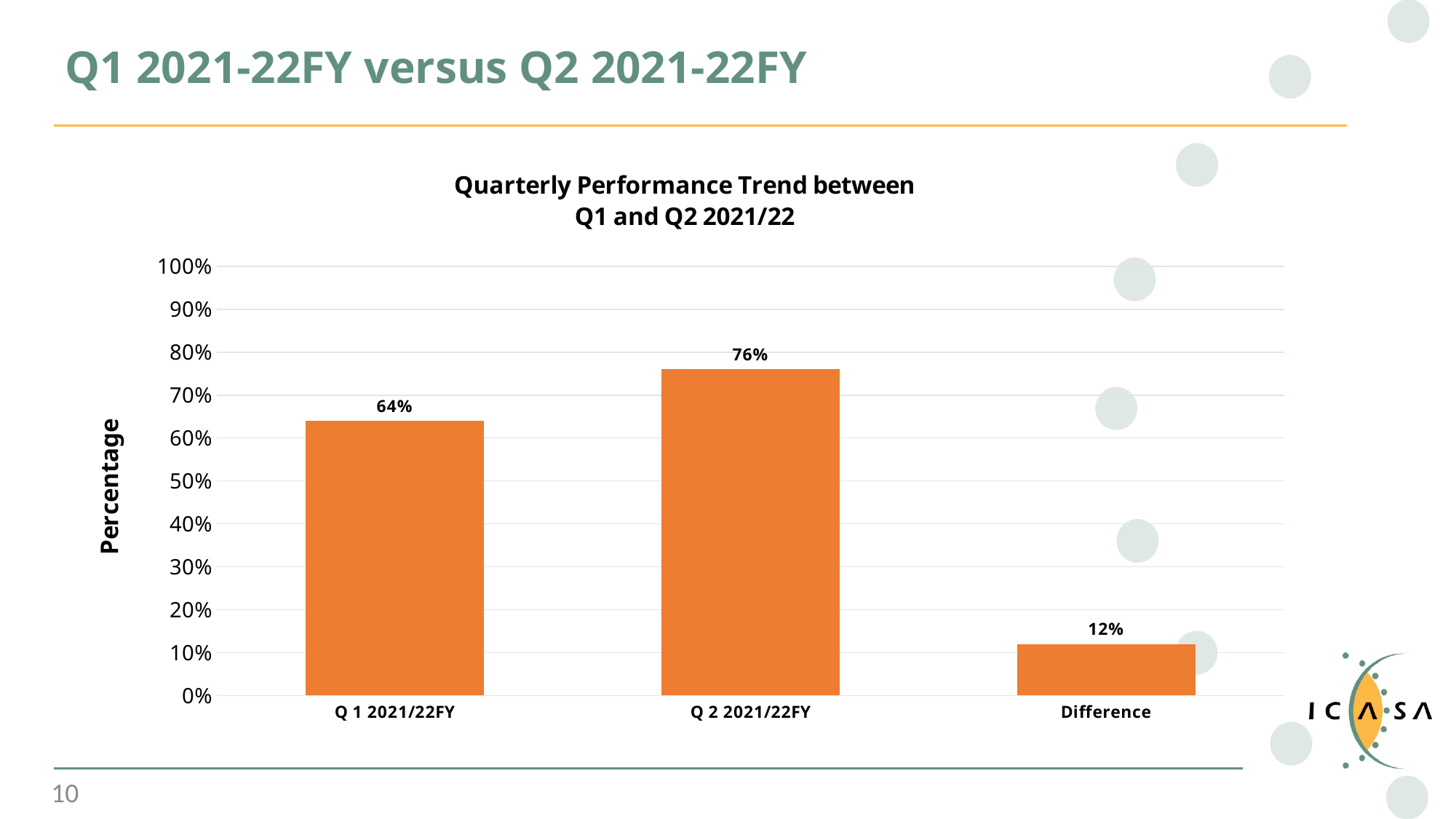
Which category has the highest value? Q 2 2021/22FY Which is larger, the value for Q 1 2021/22FY or the value for Q 2 2021/22FY? Q 2 2021/22FY What is the value for Q 1 2021/22FY? 64% What is the difference between the values for Q 2 2021/22FY and Q 1 2021/22FY? 12% What is the value for Difference? 12% What is the label of the vertical axis? Percentage Is the value for Q 2 2021/22FY greater or less than 70%? greater How many categories are shown on the x axis? 3 Which category has the lowest value? Difference What is the value for Q 2 2021/22FY? 76% What kind of chart is shown on the slide? bar chart What is the title of the chart? Quarterly Performance Trend between Q1 and Q2 2021/22